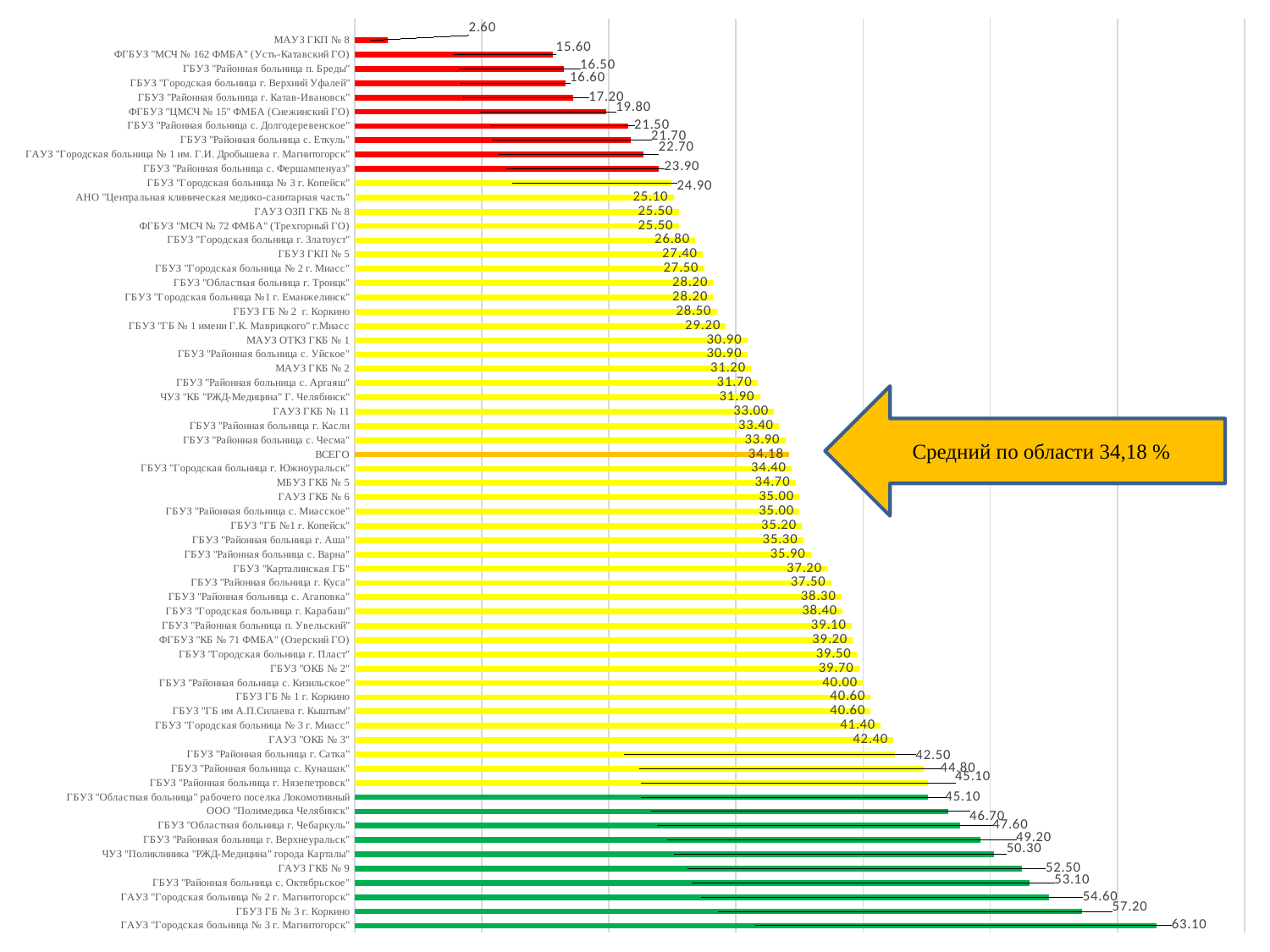
What type of chart is shown on the slide? Bar chart What is the value for ГАУЗ "Городская больница № 3 г. Магнитогорск"? 63.10 What is the difference between the values for ГБУЗ ГБ № 3 г. Коркино and ГАУЗ ГКБ № 9? 4.70 What is the value shown for ВСЕГО? 34.18 What is the value for ГБУЗ "Районная больница с. Кунашак"? 44.80 What is the value for МАУЗ ГКП № 8? 2.60 Which has a larger value: ГБУЗ "Районная больница г. Куса" or ГБУЗ "Карталинская ГБ"? ГБУЗ "Районная больница г. Куса" Which organisation has the highest value on the chart? ГАУЗ "Городская больница № 3 г. Магнитогорск" Do the values increase or decrease going from the top of the chart to the bottom? Increase What colour are the bars for the organisations with the highest values at the bottom of the chart? Green Which organisation has the lowest value on the chart? МАУЗ ГКП № 8 What does the callout arrow on the chart say? Средний по области 34,18 %